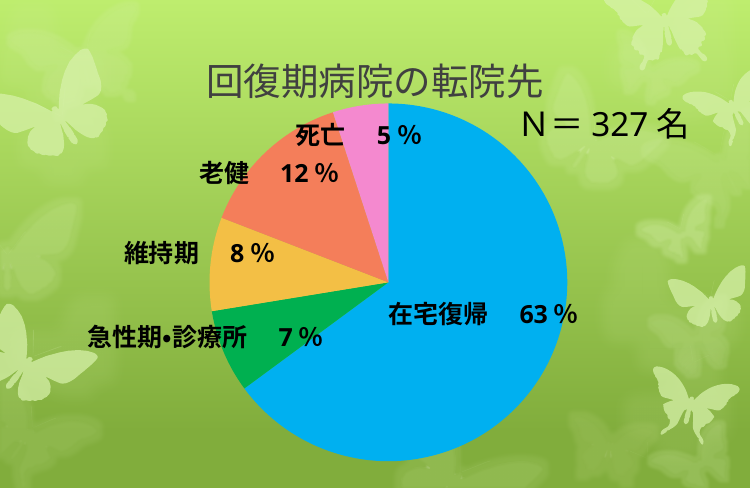
What is the share for 在宅復帰? 63 % What is the share for 老健? 12 % What is the share for 急性期・診療所? 7 % What is the difference in percentage points between 在宅復帰 and 老健? 51 What is the share for 維持期? 8 % How many categories are shown in the pie chart? 5 What kind of chart is shown on the slide? pie chart What is the share for 死亡? 5 % What is the title of the chart? 回復期病院の転院先 What is the sample size (N) shown on the slide? 327 名 Which category has the smallest share of the pie? 死亡 Which category has the largest share of the pie? 在宅復帰